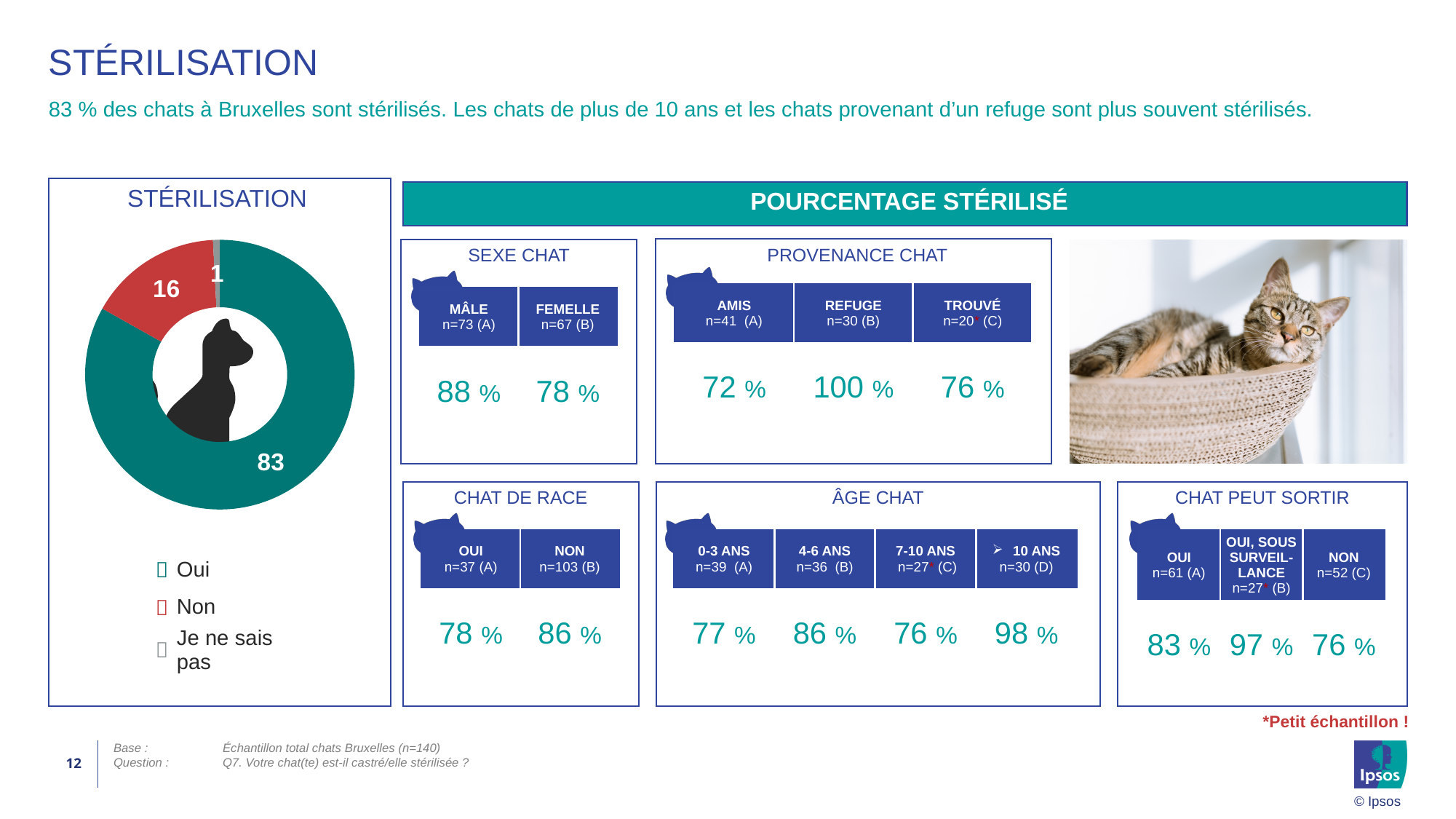
Which category has the smallest slice in the STÉRILISATION donut chart? Je ne sais pas How many categories are shown in the STÉRILISATION donut chart? 3 In the STÉRILISATION donut chart, what value is shown for Non? 16 What is the total of the three values shown in the STÉRILISATION donut chart? 100 In the STÉRILISATION donut chart, which is larger: Oui or Non? Oui In the STÉRILISATION donut chart, what value is shown for Oui? 83 How many entries does the legend of the STÉRILISATION chart list? 3 Which category has the largest slice in the STÉRILISATION donut chart? Oui In the STÉRILISATION donut chart, what is the difference between the values for Oui and Non? 67 What kind of chart is used under the heading STÉRILISATION on the left of the slide? Donut (pie) chart What colour is the Oui slice in the STÉRILISATION donut chart? Teal (green) In the STÉRILISATION donut chart, what value is shown for Je ne sais pas? 1